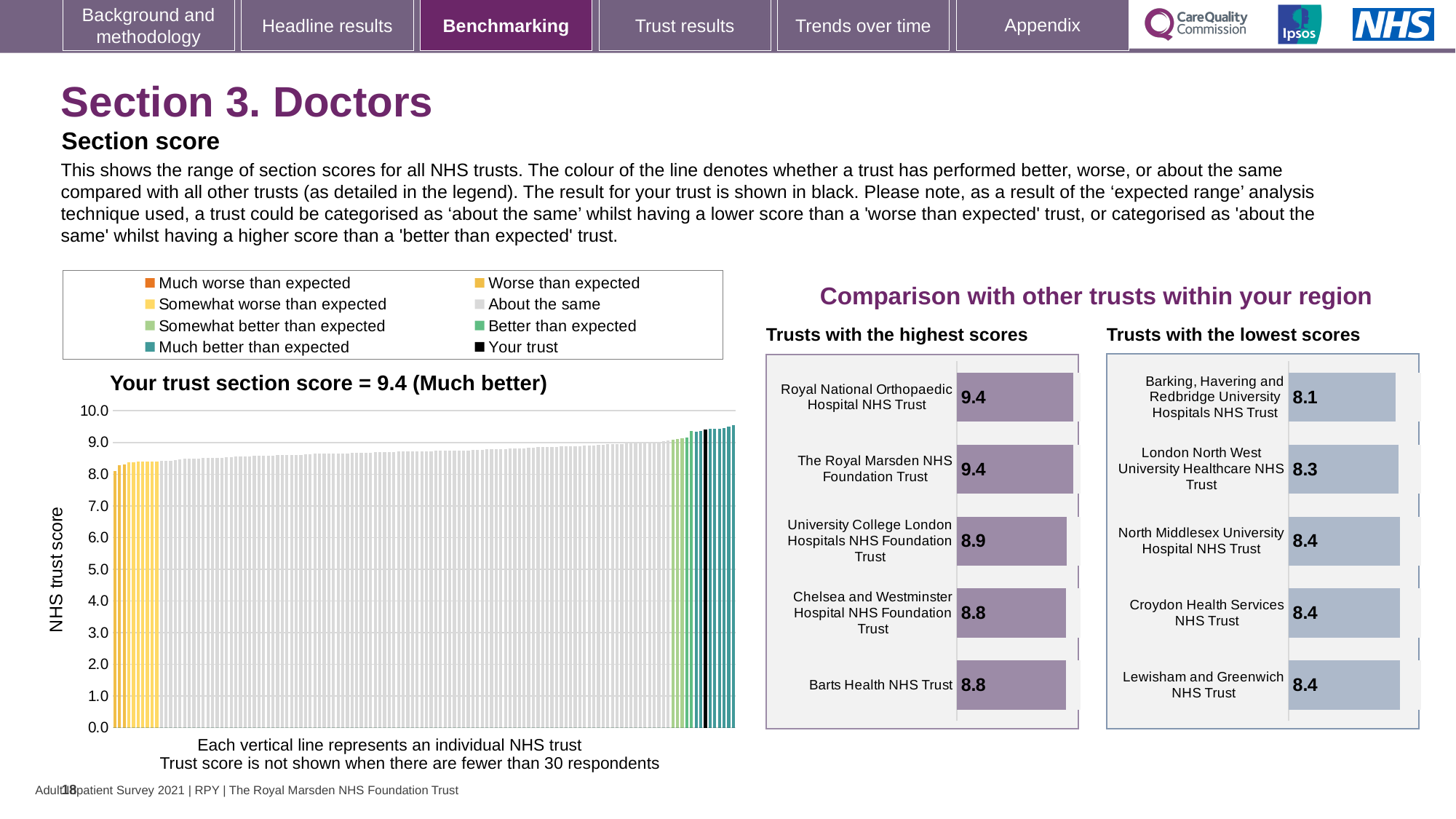
How many entries does the legend above the 'Your trust section score' chart list? 8 In the 'Your trust section score' chart, what colour is used for the bar representing your trust? black In the 'Trusts with the highest scores' chart, which has the higher score: University College London Hospitals NHS Foundation Trust or Barts Health NHS Trust? University College London Hospitals NHS Foundation Trust In the 'Trusts with the lowest scores' chart, which trust has the lowest score? Barking, Havering and Redbridge University Hospitals NHS Trust How many trusts are shown in the 'Trusts with the highest scores' chart? 5 In the 'Trusts with the lowest scores' chart, what is the difference between the scores of Lewisham and Greenwich NHS Trust and Barking, Havering and Redbridge University Hospitals NHS Trust? 0.3 In the 'Your trust section score' chart on the left, do the bar heights rise or fall from left to right along the x axis? rise In the 'Trusts with the highest scores' chart, what is the score for University College London Hospitals NHS Foundation Trust? 8.9 What kind of chart is the 'Your trust section score' chart on the left? bar chart In the 'Trusts with the lowest scores' chart, what is the score for London North West University Healthcare NHS Trust? 8.3 In the 'Trusts with the highest scores' chart, what is the difference between the scores of Royal National Orthopaedic Hospital NHS Trust and University College London Hospitals NHS Foundation Trust? 0.5 In the 'Your trust section score' chart on the left, what is the section score for your trust? 9.4